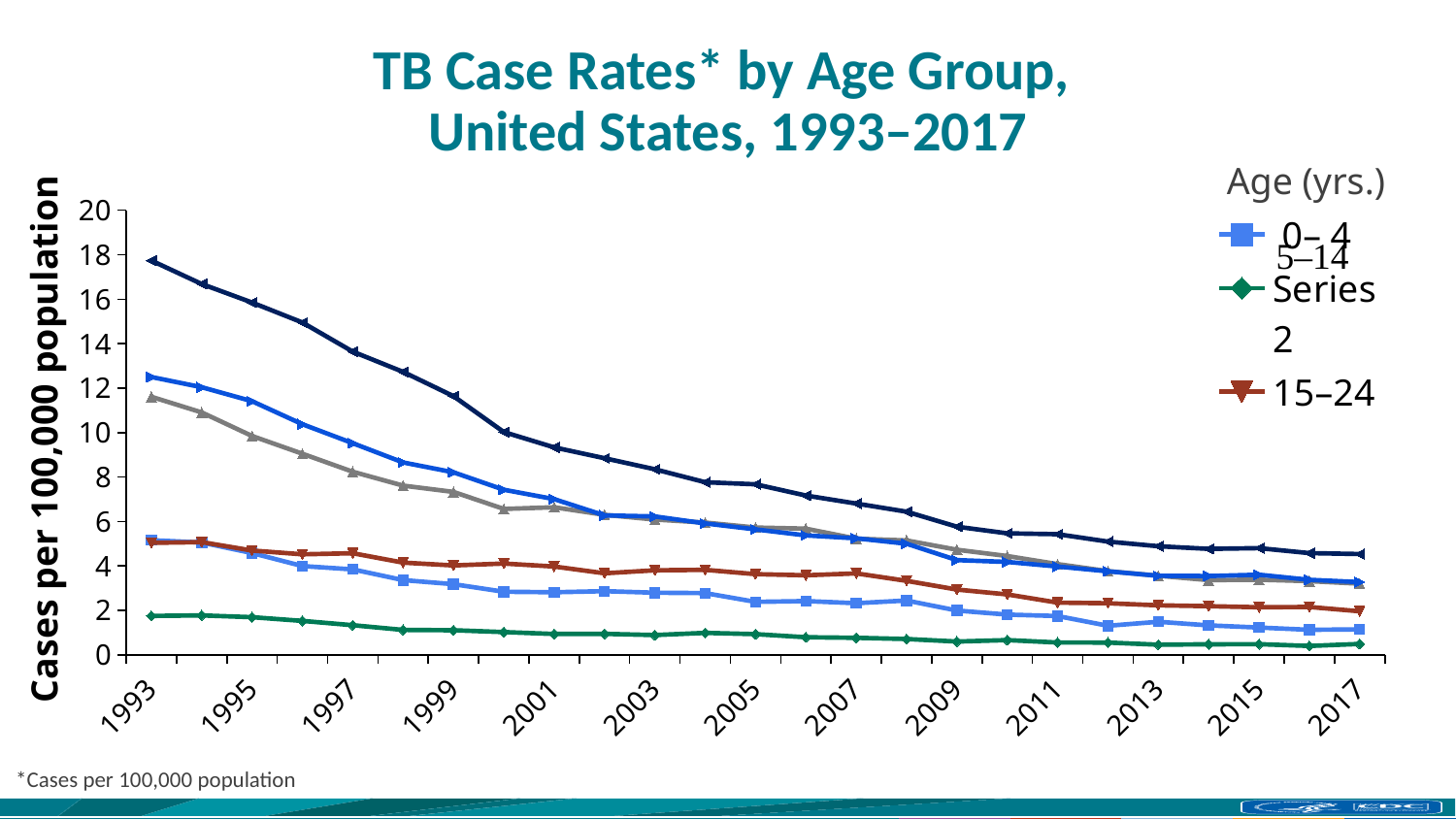
Is the value for the 15–24 age group in 2017 greater or less than 4? less How many year labels are shown on the x axis? 13 What is the title of the legend? Age (yrs.) Is the value for the 0–4 age group in 1993 greater or less than 10? less What is the title of the y axis? Cases per 100,000 population In 2017, which is larger: the value for the 0–4 age group or the 15–24 age group? 15–24 Is the value for Series 2 in 1993 greater or less than 4? less Do the values for the 0–4 age group rise or fall from 1993 to 2017? fall What kind of chart is shown on the slide? line chart